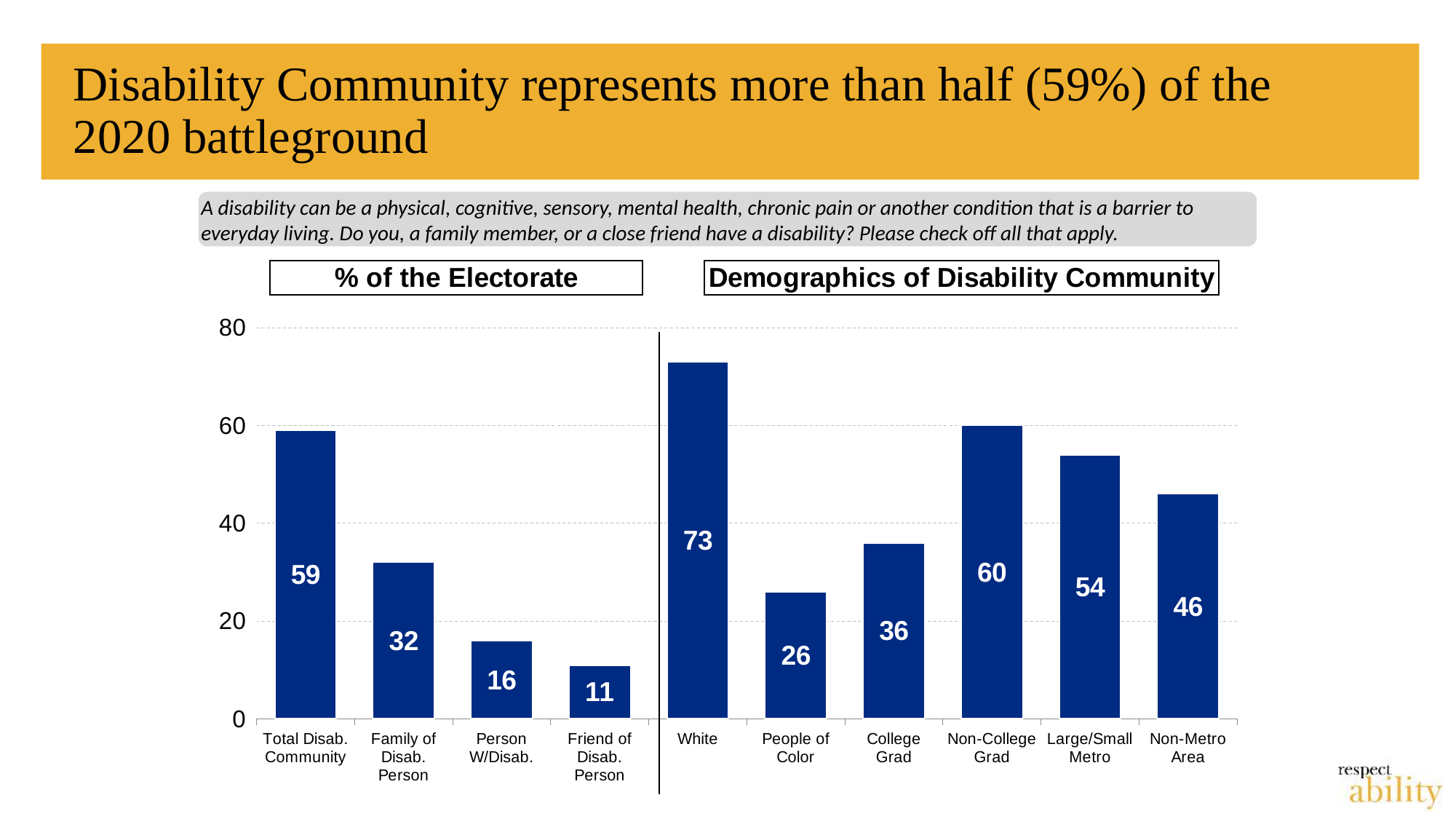
What is the difference between the values for Large/Small Metro and Non-Metro Area? 8 Which category has the highest value on the chart? White Which category has the lowest value on the chart? Friend of Disab. Person What is the value for Friend of Disab. Person? 11 What kind of chart is shown on the slide? Bar chart What is the value for Total Disab. Community? 59 How many categories are shown on the chart? 10 What is the value for Non-College Grad? 60 What are the two section headings shown above the chart? % of the Electorate; Demographics of Disability Community What is the difference between the values for White and People of Color? 47 What is the value for White in the Demographics of Disability Community section? 73 Which is larger, the value for College Grad or the value for Family of Disab. Person? College Grad